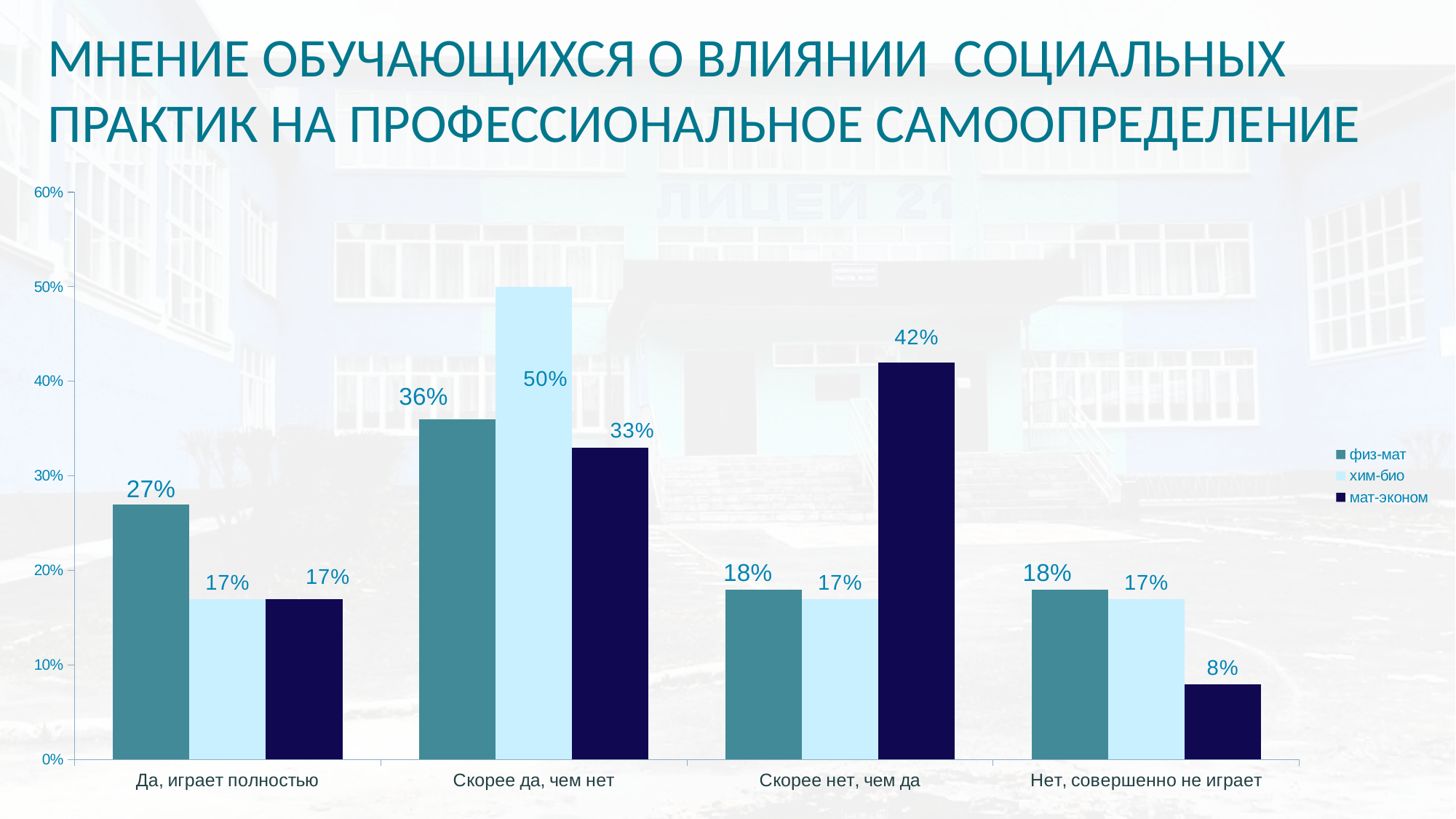
Which series is shown in the darkest (navy) colour? мат-эконом What is the value for мат-эконом in the category "Нет, совершенно не играет"? 8% Which series has the lowest value in the category "Нет, совершенно не играет"? мат-эконом Which is larger: the физ-мат value or the мат-эконом value in the category "Да, играет полностью"? физ-мат What is the value for физ-мат in the category "Да, играет полностью"? 27% How many series does the legend list? 3 What is the value for хим-био in the category "Скорее да, чем нет"? 50% What is the difference between the хим-био and физ-мат values in the category "Скорее да, чем нет"? 14% Is the value for мат-эконом in the category "Скорее нет, чем да" greater or less than 40%? greater How many categories are shown on the x axis? 4 Which series has the highest value in the category "Скорее нет, чем да"? мат-эконом What kind of chart is shown on the slide? bar chart